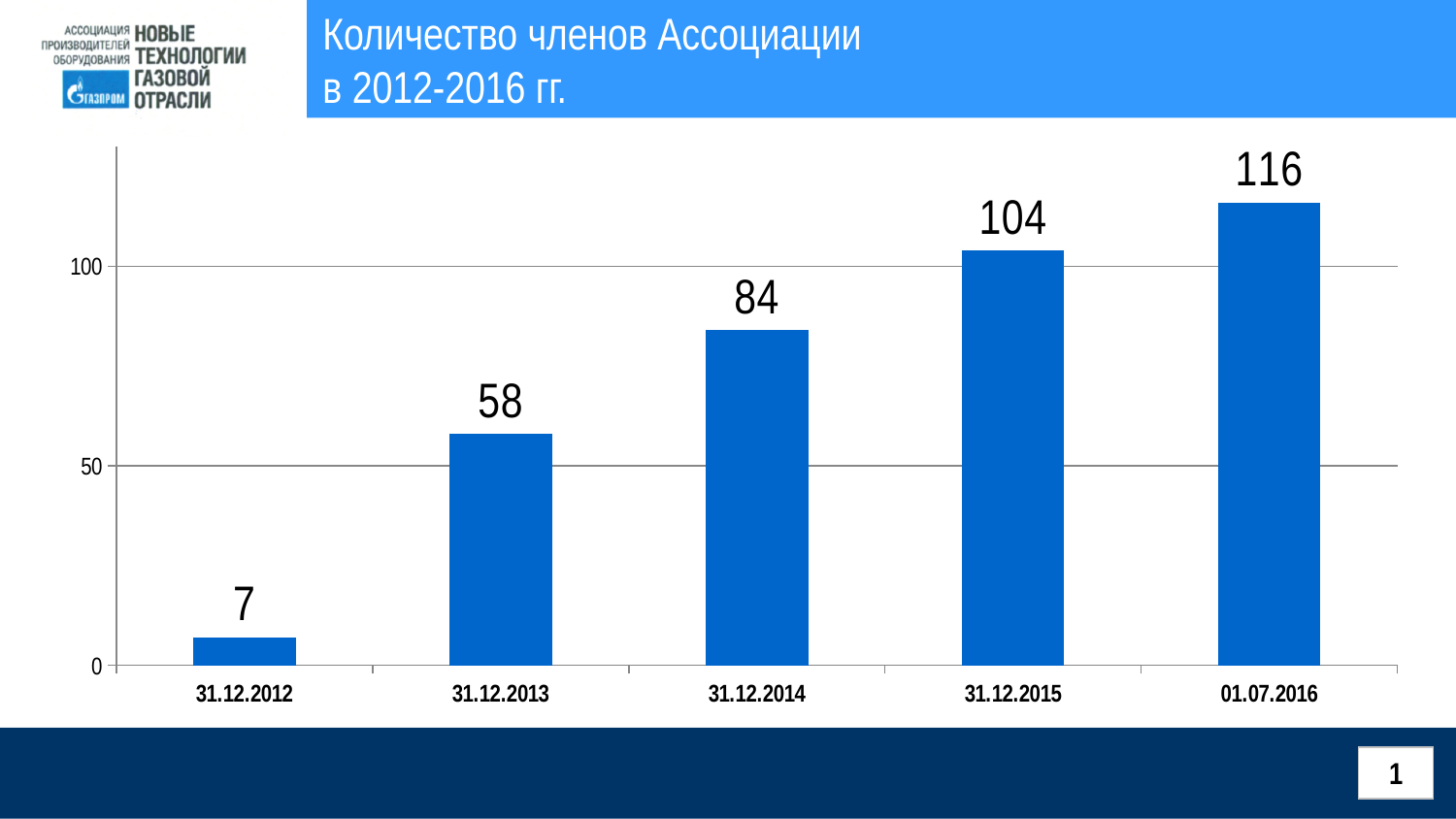
What is the difference between the number of members on 31.12.2013 and on 31.12.2012? 51 Which date has the lowest number of Association members? 31.12.2012 What is the number of Association members on 31.12.2012? 7 Do the values rise or fall from 31.12.2012 to 01.07.2016? rise What is the difference between the number of members on 31.12.2015 and on 31.12.2014? 20 Which date has the highest number of Association members? 01.07.2016 What kind of chart is shown on the slide? bar chart What is the number of Association members on 01.07.2016? 116 What is the number of Association members on 31.12.2014? 84 Is the value for 31.12.2014 greater or less than 100? less How many dates are shown on the x axis of the chart? 5 Which is larger: the number of members on 31.12.2013 or on 31.12.2015? 31.12.2015